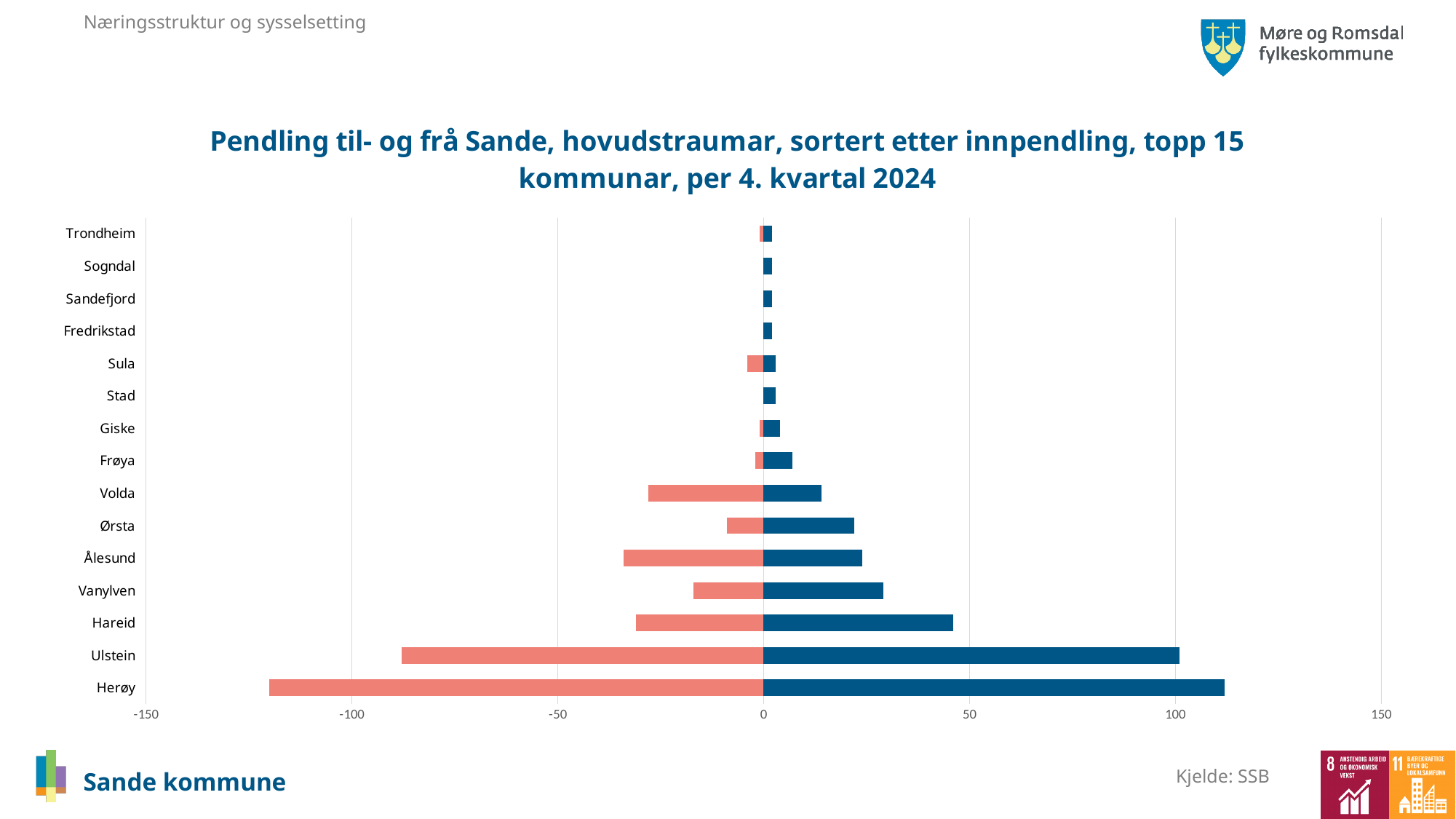
Is the red bar value for Herøy greater or less than -100? less Which has the longer red bar, Ulstein or Hareid? Ulstein What kind of chart is shown on the slide? bar chart Is the blue bar value for Hareid greater or less than 50? less How many municipalities (categories) are listed on the vertical axis of the chart? 15 Which municipality has the longest red bar extending furthest to the left in the chart? Herøy Which municipality is listed at the top of the vertical axis in the chart? Trondheim Which has the larger blue bar, Hareid or Vanylven? Hareid Is the red bar value for Ålesund greater or less than -50? greater Which municipality has the longest blue bar (highest innpendling) in the chart? Herøy